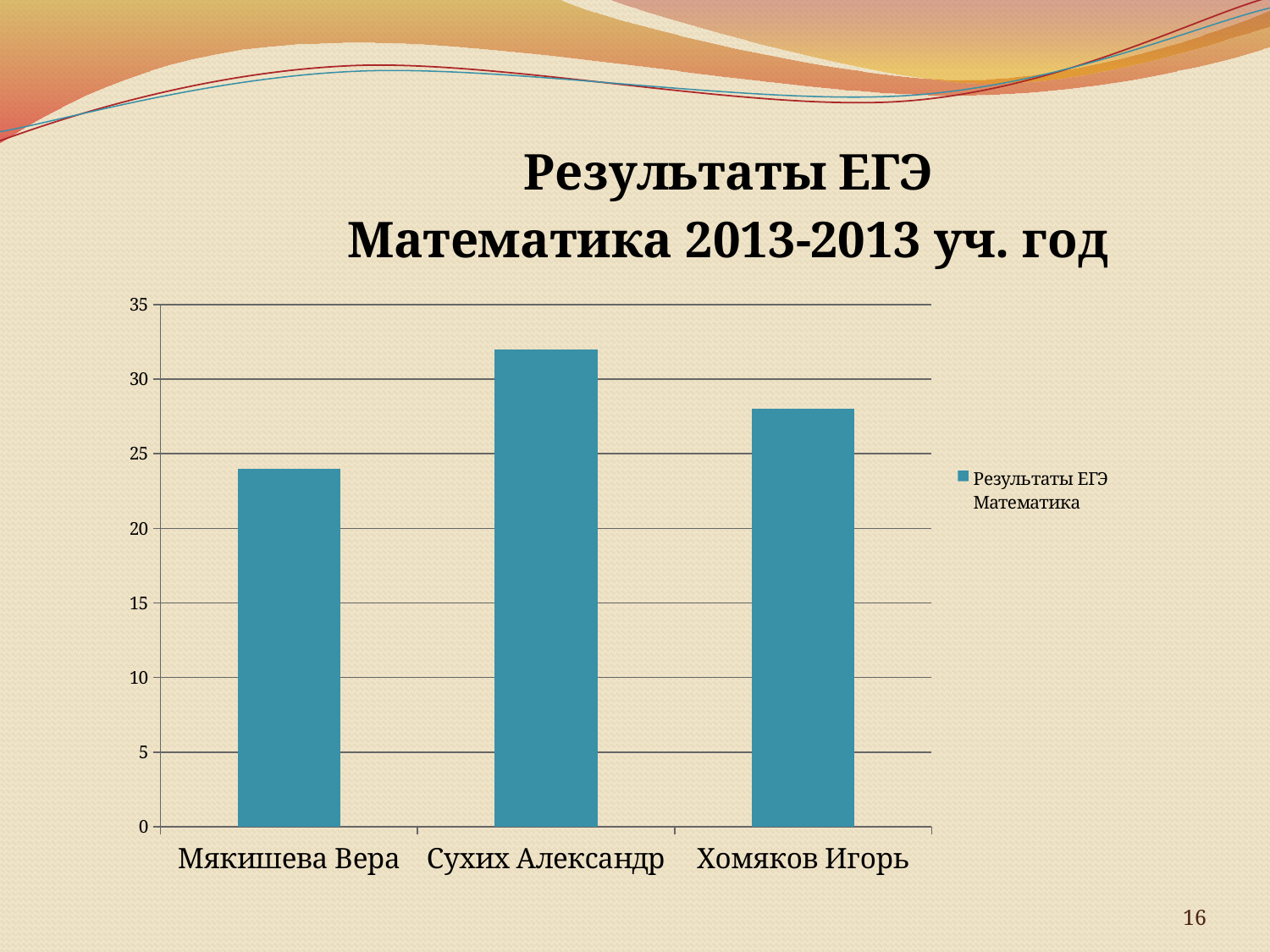
What is the name of the series shown in the chart legend? Результаты ЕГЭ Математика Is the value for Сухих Александр greater or less than 30? greater Which student has the lowest bar in the chart? Мякишева Вера Is the value for Хомяков Игорь greater or less than 25? greater Which is larger, the value for Хомяков Игорь or the value for Мякишева Вера? Хомяков Игорь Which student has the highest bar in the chart? Сухих Александр How many series does the chart legend list? 1 What kind of chart is shown on the slide? bar chart Is the value for Мякишева Вера greater or less than 25? less How many students (categories) are shown on the x axis of the chart? 3 What is the title of the chart on the slide? Результаты ЕГЭ Математика 2013-2013 уч. год